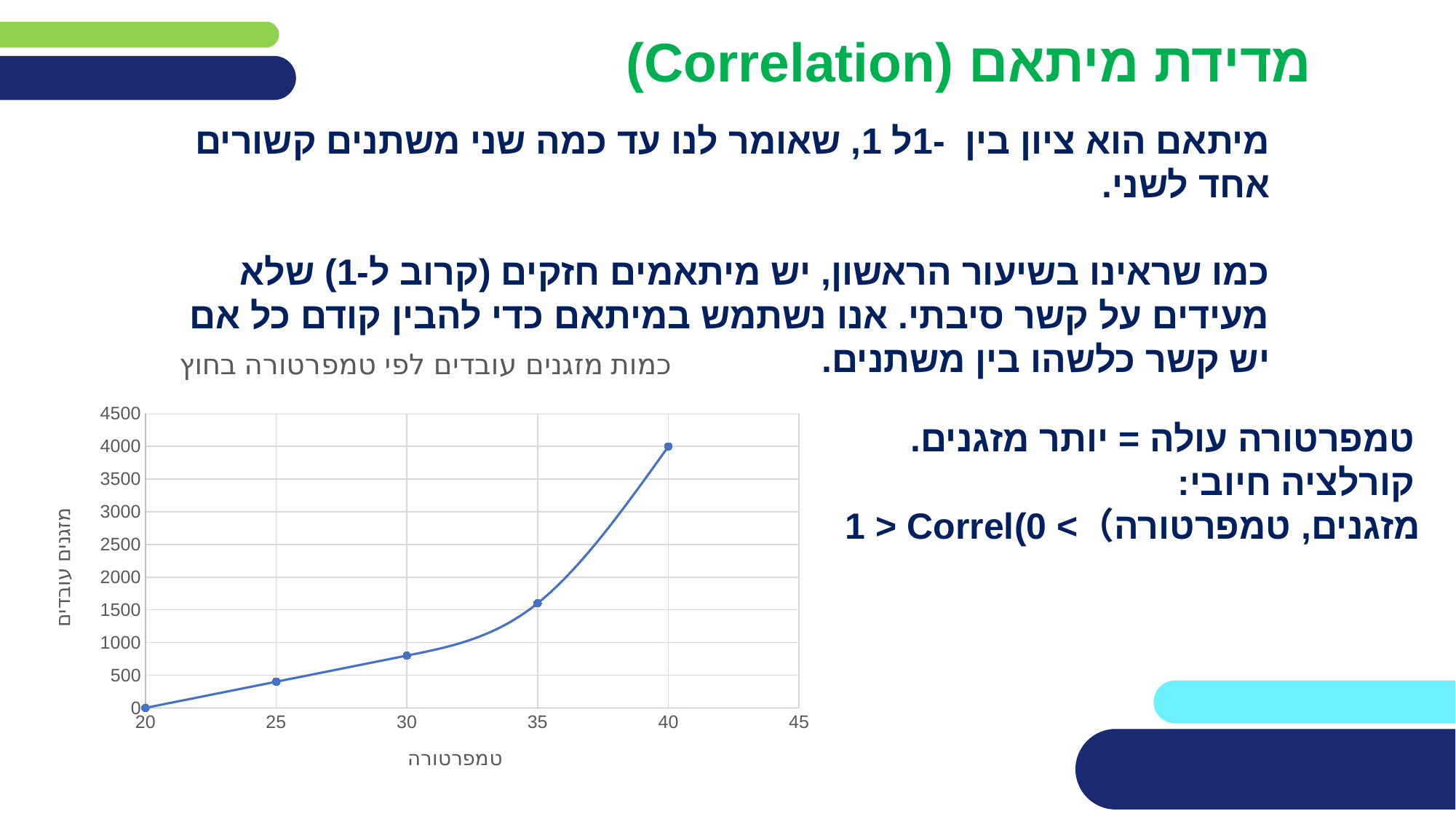
What kind of chart is shown on the slide? line chart What is the title of the chart? כמות מזגנים עובדים לפי טמפרטורה בחוץ What is the label of the x axis of the chart? טמפרטורה At which temperature is the number of working air conditioners highest? 40 At which temperature is the number of working air conditioners lowest? 20 Is the value at temperature 35 greater or less than 1500? greater Which has a larger value, temperature 30 or temperature 35? 35 How many data points are plotted on the chart? 5 Is the value at temperature 25 greater or less than 500? less Do the values rise or fall as temperature increases along the x axis? rise What is the value of מזגנים עובדים at temperature 20? 0 What is the value of מזגנים עובדים at temperature 40? 4000